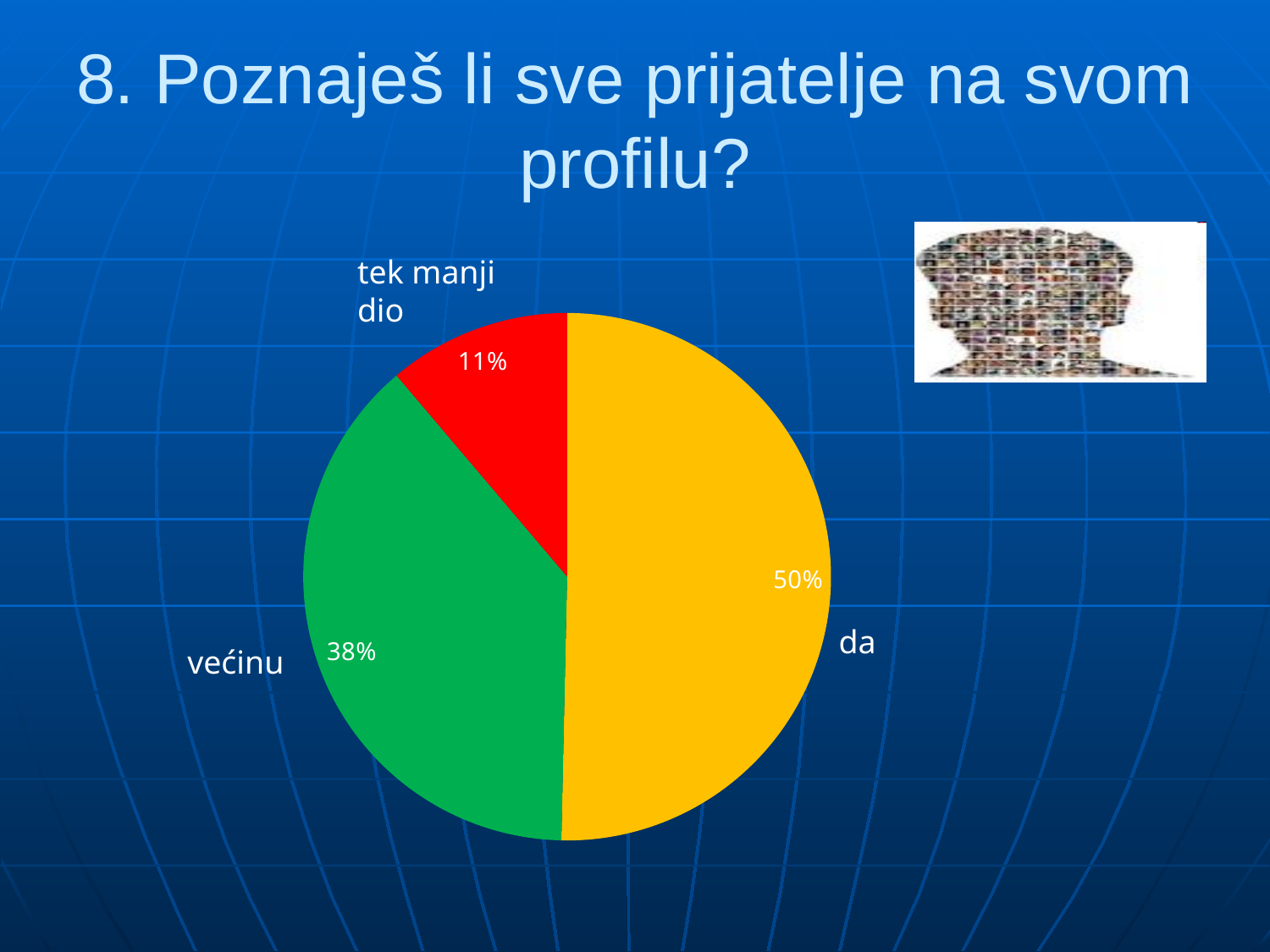
What percentage is shown for the "da" slice? 50% Which slice of the pie is the largest? da What colour is the "da" slice? yellow Which is larger, the "većinu" slice or the "tek manji dio" slice? većinu What is the difference in percentage points between the "većinu" slice and the "tek manji dio" slice? 27 What is the difference in percentage points between the "da" slice and the "većinu" slice? 12 What percentage is shown for the "tek manji dio" slice? 11% What percentage is shown for the "većinu" slice? 38% What kind of chart is shown on the slide? pie chart What colour is the "tek manji dio" slice? red How many slices does the pie chart have? 3 Which slice of the pie is the smallest? tek manji dio